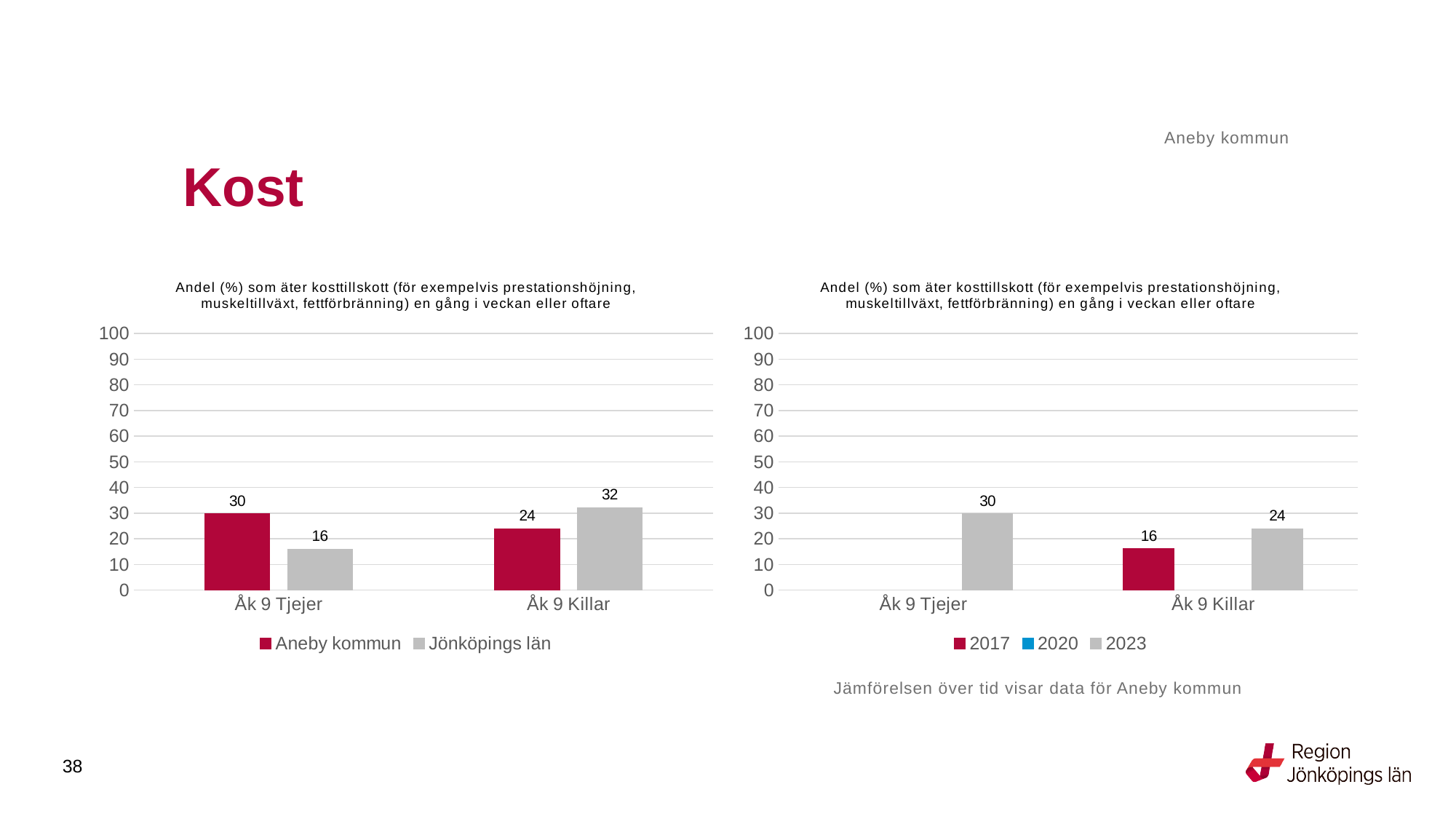
In the left chart, what is the value for Aneby kommun for Åk 9 Tjejer? 30 In the left chart, which bar has the lowest value? Jönköpings län, Åk 9 Tjejer In the right chart, how many series does the legend list? 3 In the left chart, what is the difference between Aneby kommun and Jönköpings län for Åk 9 Tjejer? 14 In the left chart, what is the value for Jönköpings län for Åk 9 Killar? 32 In the left chart, which is larger for Åk 9 Killar: Aneby kommun or Jönköpings län? Jönköpings län In the left chart, how many series does the legend list? 2 In the right chart, what is the value for 2017 for Åk 9 Killar? 16 How many categories are shown on the x axis of the left chart? 2 In the right chart, what is the value for 2023 for Åk 9 Tjejer? 30 What kind of chart is the right chart? Bar chart In the right chart, what is the difference between 2023 and 2017 for Åk 9 Killar? 8